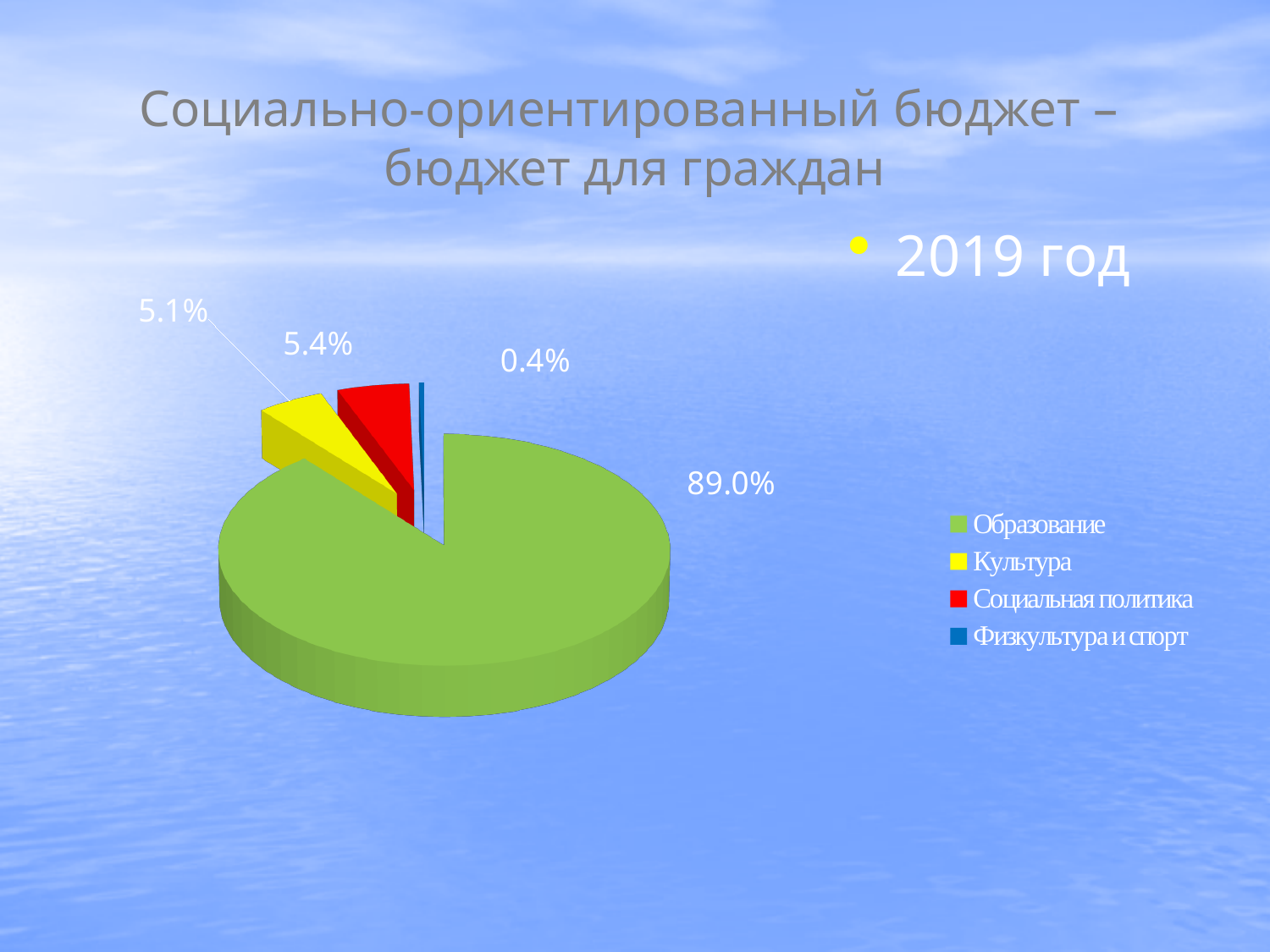
What is the difference between the shares for Социальная политика and Культура? 0.3% Which category has the largest slice of the pie? Образование How many categories does the legend list? 4 What share of the pie does Образование have? 89.0% Which category has the smallest slice of the pie? Физкультура и спорт What share of the pie does Культура have? 5.1% Which is larger, the share for Культура or the share for Социальная политика? Социальная политика What share of the pie does Физкультура и спорт have? 0.4% What kind of chart is shown on the slide? pie chart Which year is shown next to the chart? 2019 год What share of the pie does Социальная политика have? 5.4% What colour is the slice for Социальная политика? red